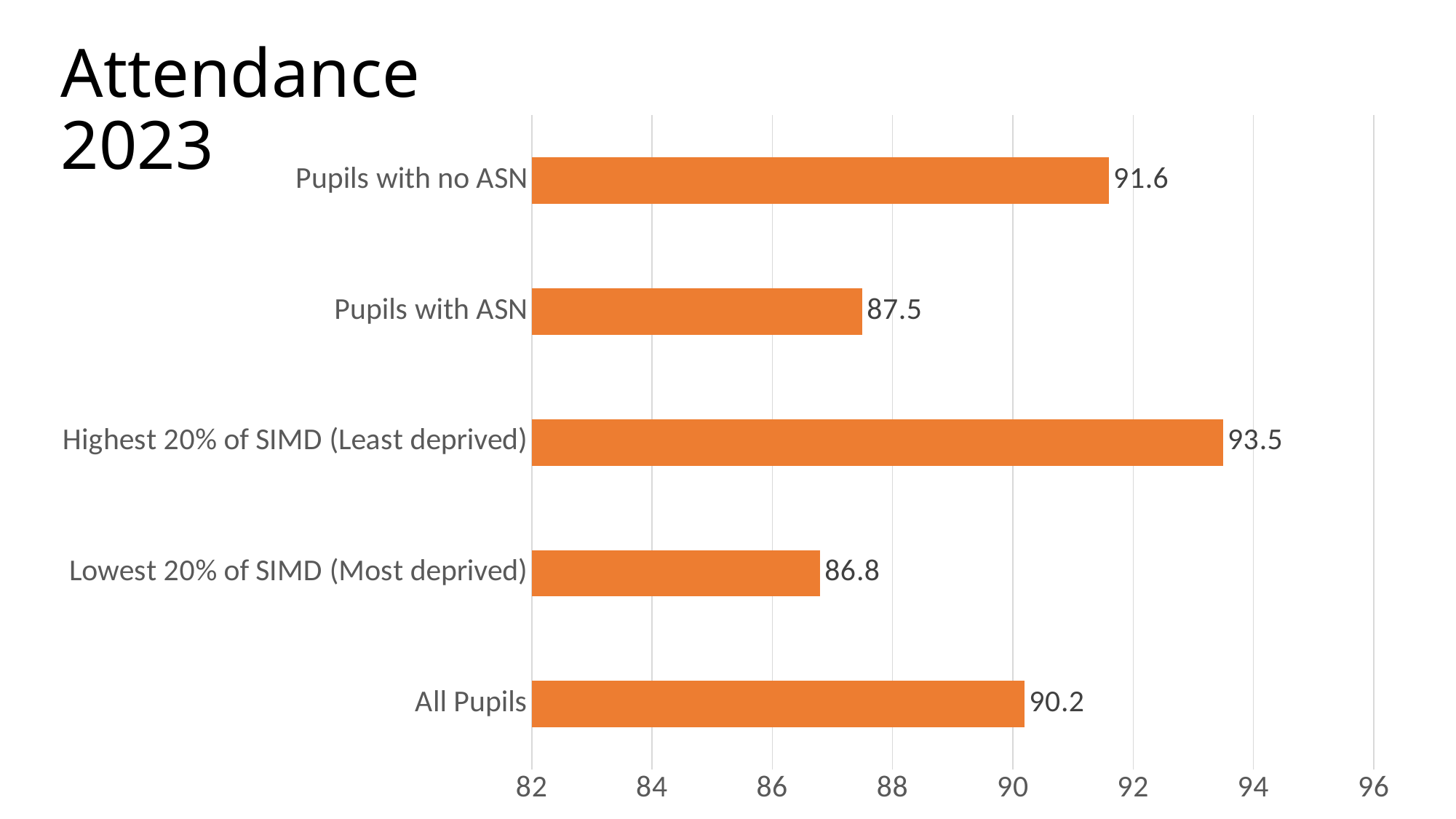
What is the attendance value for Lowest 20% of SIMD (Most deprived)? 86.8 Which category has the lowest attendance value? Lowest 20% of SIMD (Most deprived) Which is larger, the attendance value for Pupils with no ASN or for All Pupils? Pupils with no ASN What is the difference between the attendance values for Highest 20% of SIMD (Least deprived) and Lowest 20% of SIMD (Most deprived)? 6.7 What kind of chart is shown on the slide? bar chart What is the difference between the attendance values for Pupils with no ASN and Pupils with ASN? 4.1 What is the attendance value for Pupils with ASN? 87.5 What is the title of the slide? Attendance 2023 What is the attendance value for All Pupils? 90.2 Which category has the highest attendance value? Highest 20% of SIMD (Least deprived) Is the attendance value for Pupils with ASN greater or less than 88? less How many categories are shown in the chart? 5